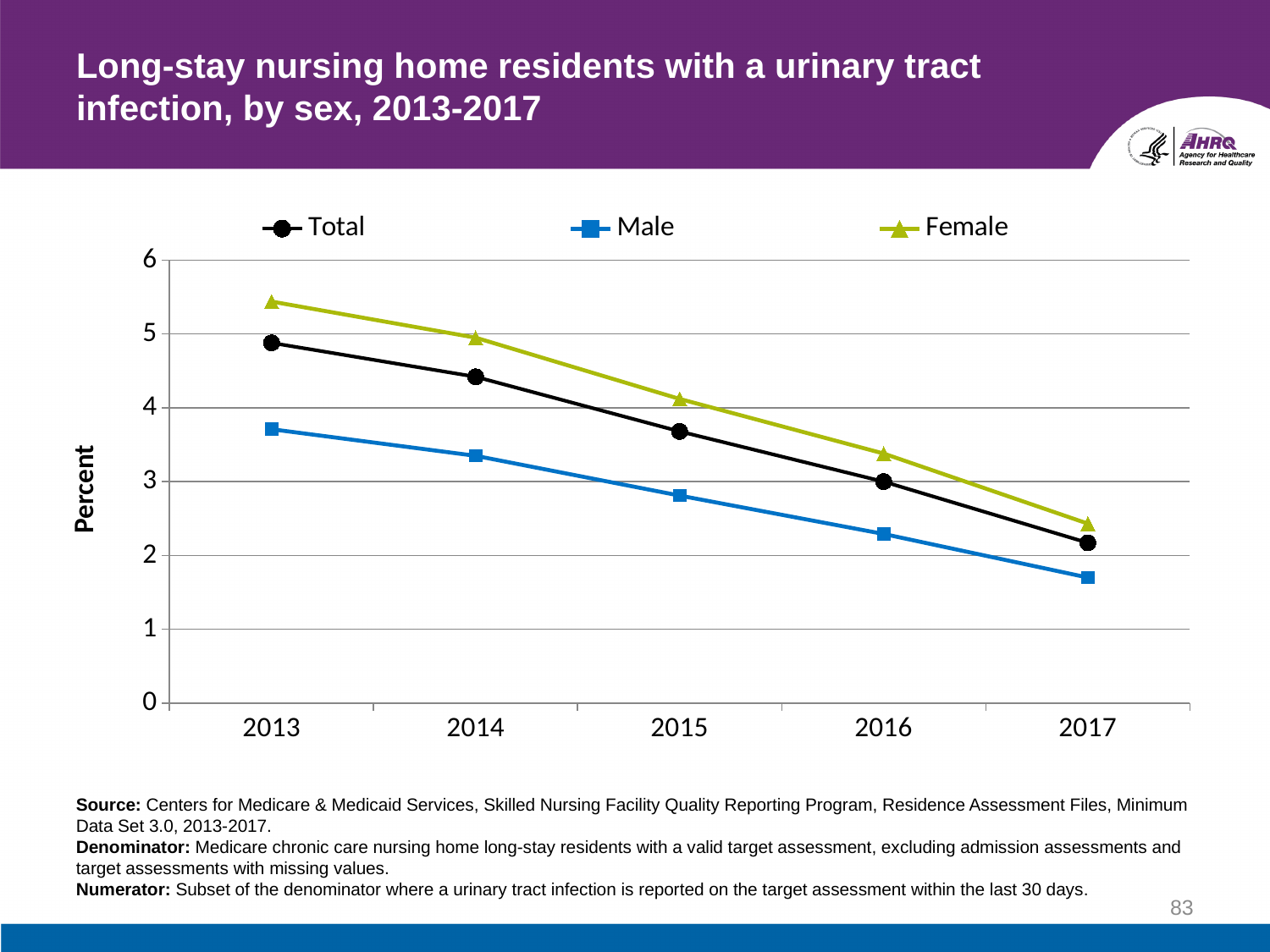
Is the value for Male in 2017 greater or less than 2? less How many years are plotted along the x axis? 5 Is the value for Male in 2013 greater or less than 3? greater Do the values for the Total series rise or fall from 2013 to 2017? fall How many series does the legend list? 3 Is the value for Total in 2015 greater or less than 4? less What is the label on the y axis? Percent Which is larger in 2016, the value for Male or the value for Female? Female What kind of chart is shown on the slide? line chart Which series has the lowest value in 2017? Male Which series has the highest value in 2013? Female